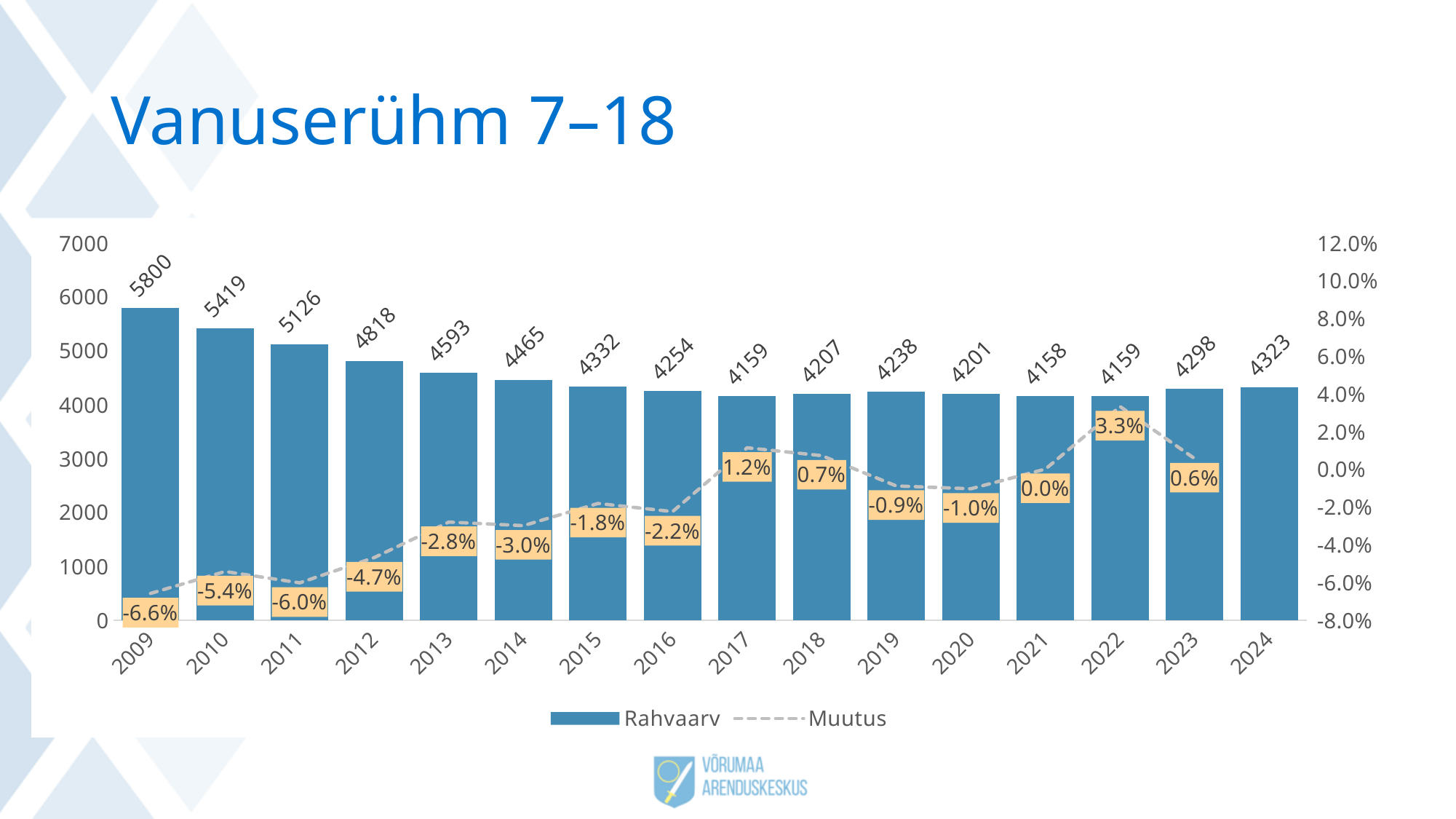
Which year has the lowest Rahvaarv value? 2021 What kind of chart is used for the Rahvaarv series? Bar chart What is the difference between the Rahvaarv values for 2009 and 2010? 381 What is the Rahvaarv value for 2024? 4323 Which is larger, the Rahvaarv value for 2018 or for 2019? 2019 Which year has the highest Rahvaarv value? 2009 How many series does the legend list? 2 What is the Muutus value shown for 2022? 3.3% How many years are shown on the x axis? 16 What is the Rahvaarv value for 2009? 5800 Do the Rahvaarv values rise or fall from 2009 to 2013? Fall What is the Muutus value shown for 2011? -6.0%